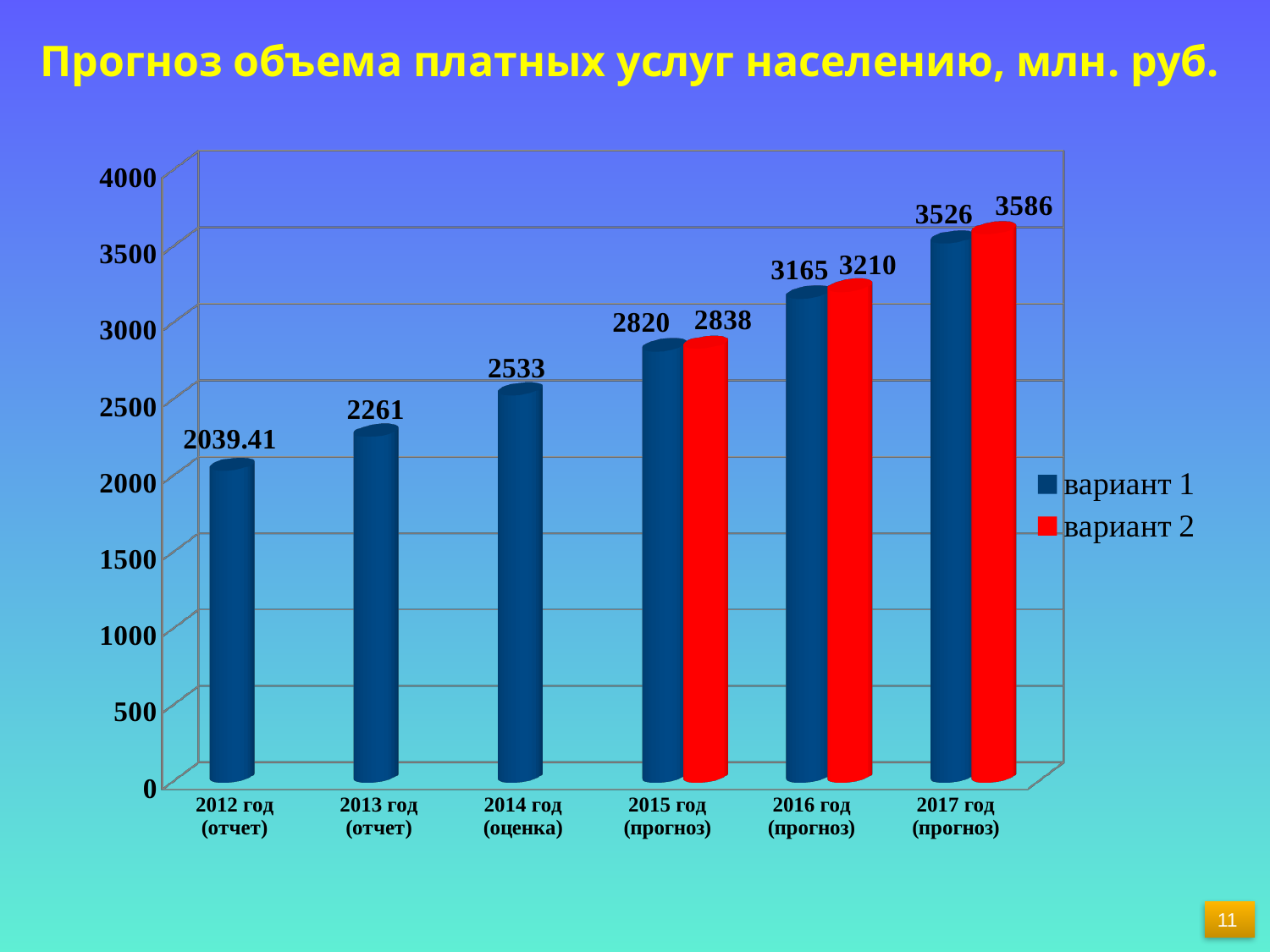
What is the value for вариант 2 in 2017 год (прогноз)? 3586 Which year has the lowest value for вариант 1? 2012 год (отчет) Do the values for вариант 1 rise or fall from 2012 to 2017? rise What is the value for вариант 2 in 2015 год (прогноз)? 2838 Which is larger in 2017 год (прогноз): вариант 1 or вариант 2? вариант 2 Which year has the highest value for вариант 1? 2017 год (прогноз) How many series does the legend list? 2 How many year categories are shown on the x axis? 6 What is the value for вариант 1 in 2014 год (оценка)? 2533 What kind of chart is shown on the slide? bar chart What is the value for вариант 1 in 2012 год (отчет)? 2039.41 What is the difference between вариант 2 and вариант 1 in 2016 год (прогноз)? 45